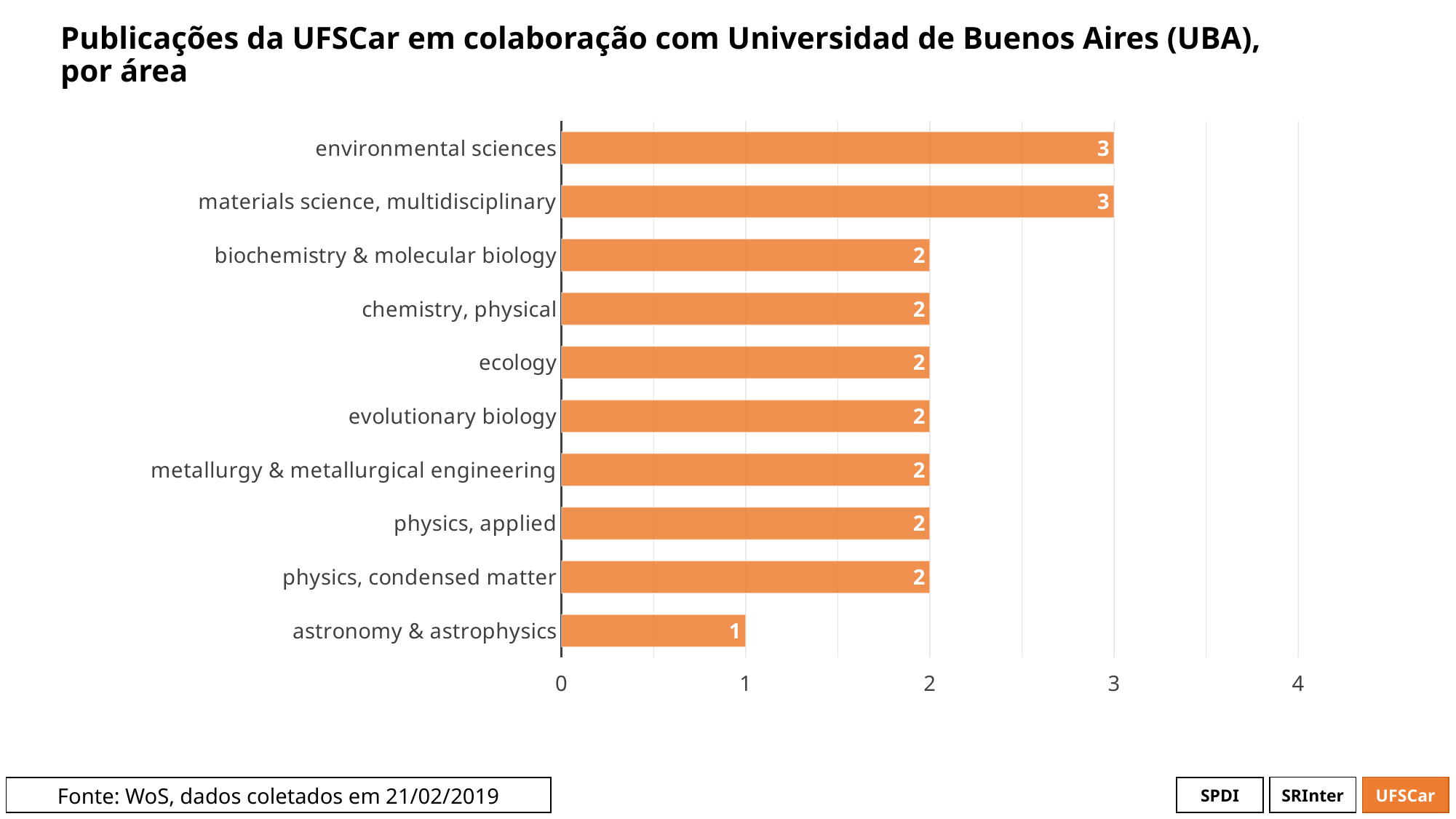
What is the value for ecology? 2 What is the value for astronomy & astrophysics? 1 What is the difference between the values for materials science, multidisciplinary and physics, applied? 1 How many categories are shown in the chart? 10 What is the title of the chart? Publicações da UFSCar em colaboração com Universidad de Buenos Aires (UBA), por área Which is larger, the value for chemistry, physical or the value for astronomy & astrophysics? chemistry, physical Which category has the lowest value? astronomy & astrophysics What kind of chart is shown on the slide? bar chart What is the value for metallurgy & metallurgical engineering? 2 What is the value for environmental sciences? 3 What is the difference between the values for environmental sciences and astronomy & astrophysics? 2 Which is larger, the value for materials science, multidisciplinary or the value for evolutionary biology? materials science, multidisciplinary